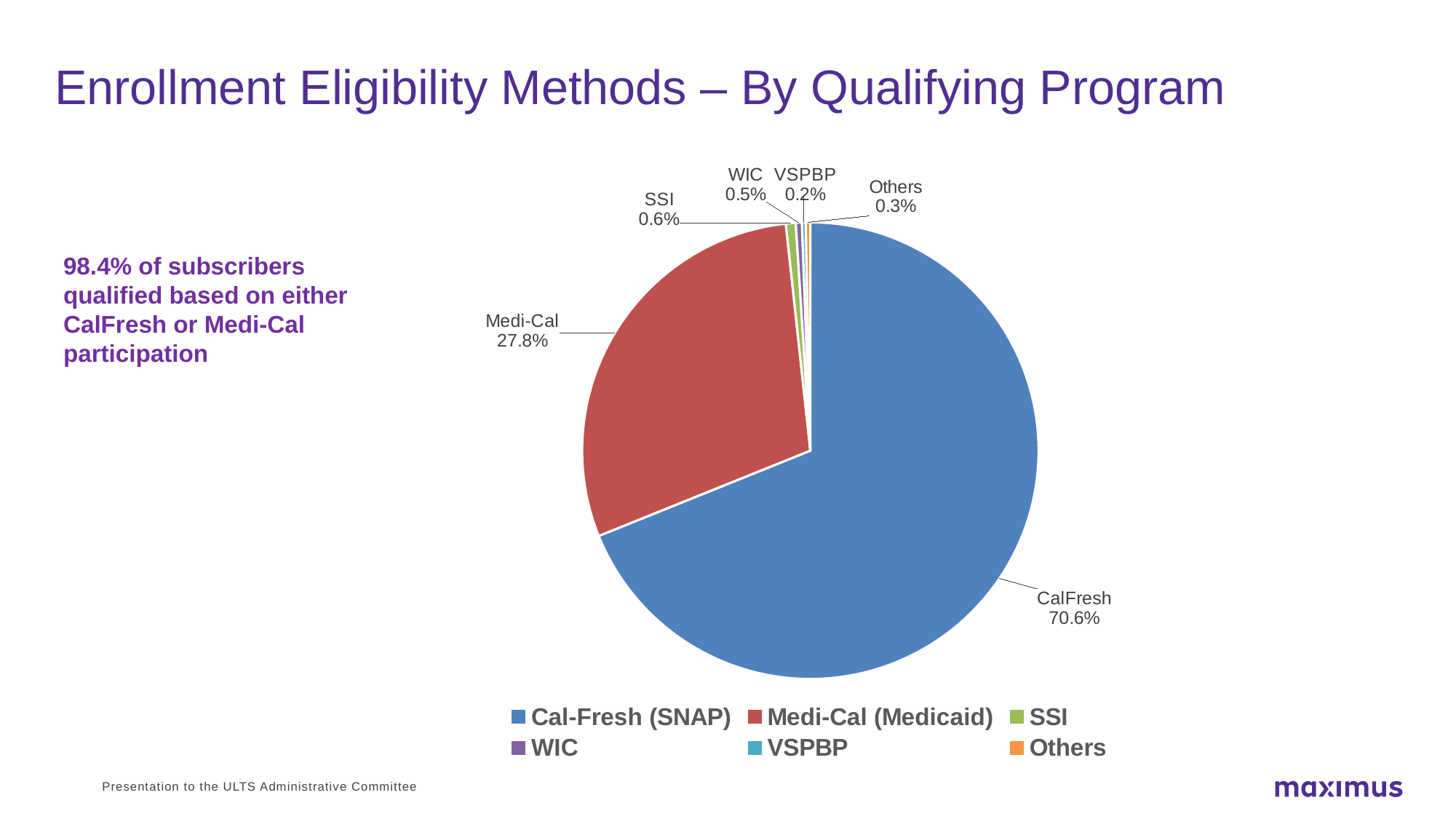
Which is larger, the SSI slice or the Others slice? SSI What percentage is shown for VSPBP? 0.2% What is the value shown for Medi-Cal? 27.8% What colour is the Medi-Cal (Medicaid) slice? Red What percentage is shown for WIC? 0.5% What percentage is shown for SSI? 0.6% What share of the pie does CalFresh account for? 70.6% Which category has the smallest slice of the pie? VSPBP What is the difference in percentage points between CalFresh and Medi-Cal? 42.8 What type of chart is shown on the slide? Pie chart How many categories are shown in the pie chart? 6 Which category has the largest slice of the pie? CalFresh